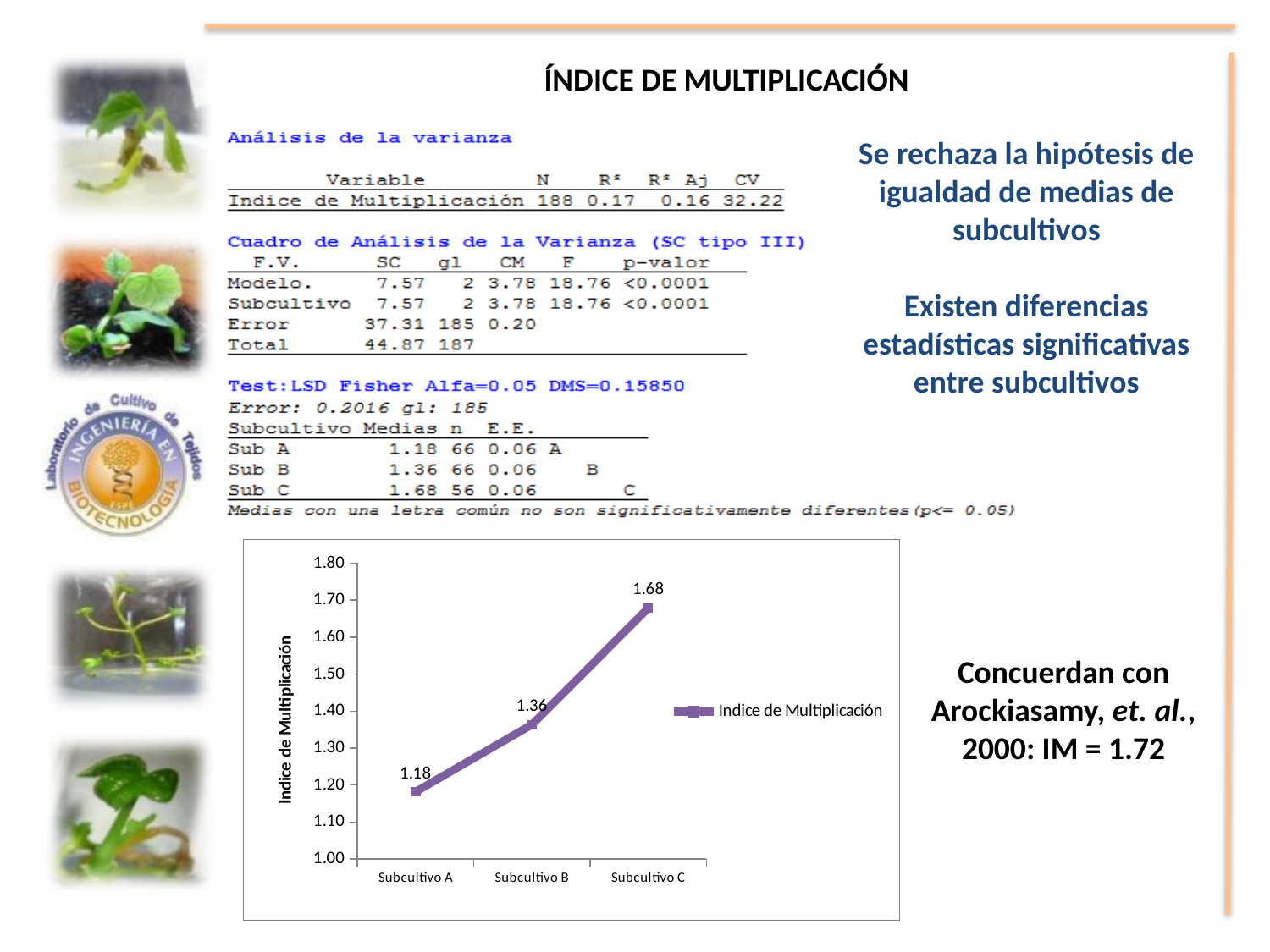
What is the value of Indice de Multiplicación for Subcultivo C? 1.68 What is the value of Indice de Multiplicación for Subcultivo A? 1.18 Is the value for Subcultivo B greater or less than 1.40? less What is the difference in Indice de Multiplicación between Subcultivo C and Subcultivo A? 0.50 How many subcultivos are plotted on the x axis of the chart? 3 What kind of chart is shown on the slide? line chart What is the difference in Indice de Multiplicación between Subcultivo B and Subcultivo A? 0.18 What is the value of Indice de Multiplicación for Subcultivo B? 1.36 Which subcultivo has the highest Indice de Multiplicación? Subcultivo C Which has a larger Indice de Multiplicación, Subcultivo B or Subcultivo C? Subcultivo C Do the values rise or fall from Subcultivo A to Subcultivo C? rise Which subcultivo has the lowest Indice de Multiplicación? Subcultivo A